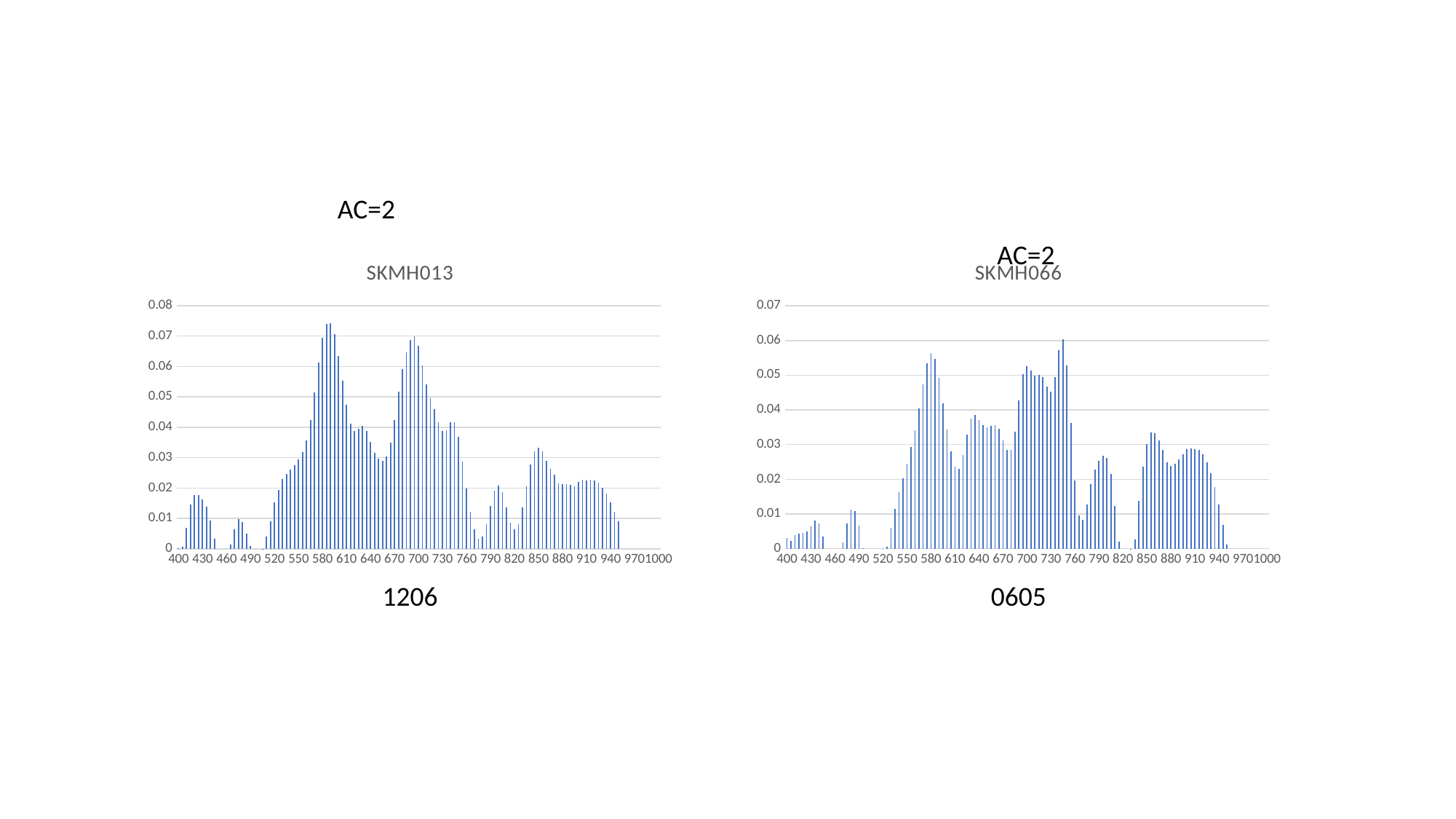
In the SKMH066 chart, is the value at 580 greater or less than 0.05? greater In the SKMH013 chart, is the value at 700 larger than the value at 850? yes In the SKMH066 chart, is the value at 460 greater or less than 0.01? less In the SKMH066 chart, is the value at 640 greater or less than 0.03? greater What kind of chart is the SKMH013 chart on the left? bar chart In the SKMH066 chart, is the value at 740 larger than the value at 880? yes What is the highest value shown on the y axis of the SKMH013 chart? 0.08 What is the title of the chart on the right? SKMH066 Which chart has the taller peak bar, SKMH013 or SKMH066? SKMH013